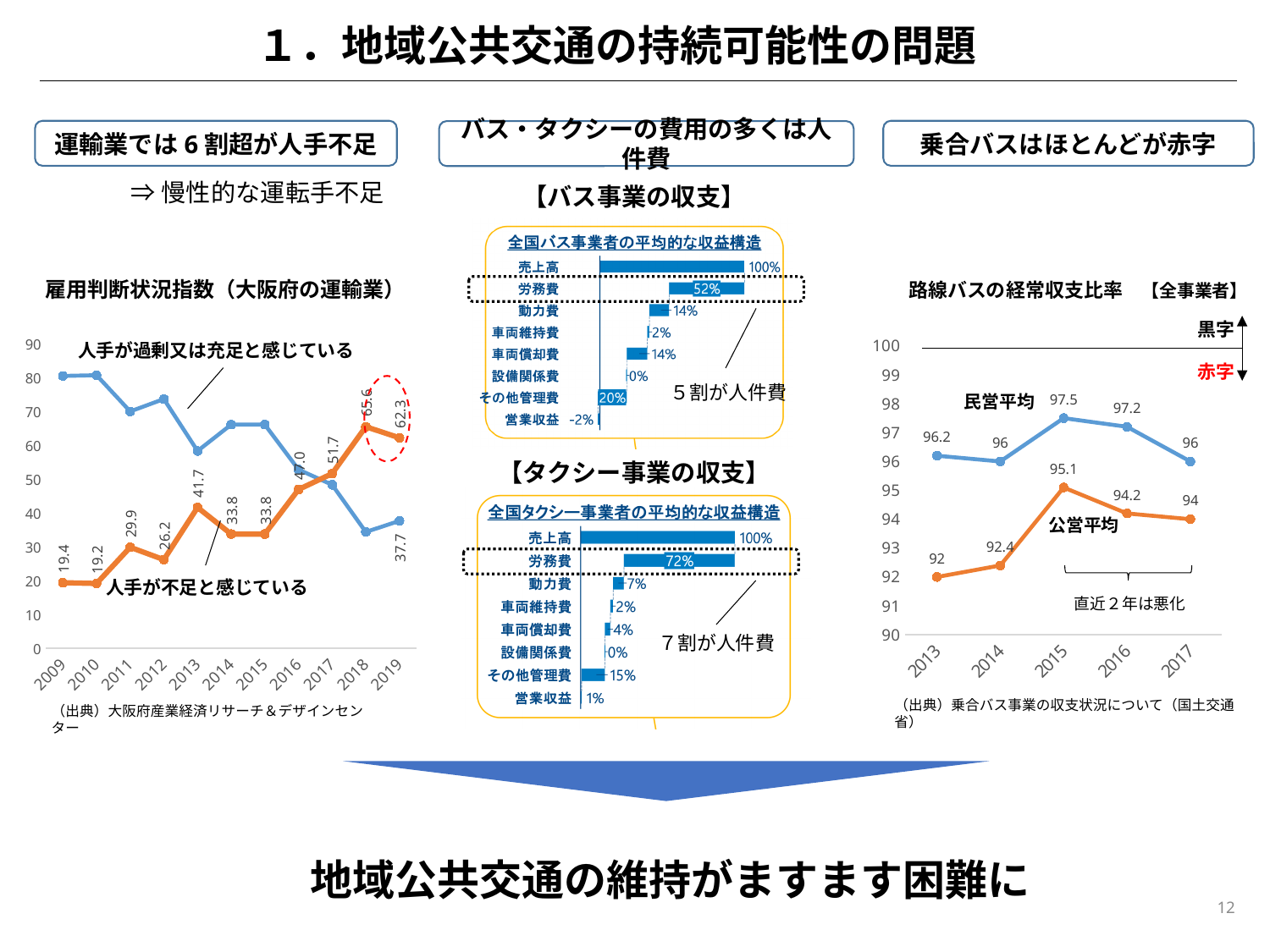
In the 雇用判断状況指数（大阪府の運輸業） chart, what is the value of the 人手が不足と感じている line in 2018? 65.6 In the 路線バスの経常収支比率 chart, what is the 公営平均 value in 2015? 95.1 In the 全国タクシー事業者の平均的な収益構造 chart, what percentage is 労務費? 72% In the 路線バスの経常収支比率 chart, what is the difference between 民営平均 and 公営平均 in 2013? 4.2 In the 雇用判断状況指数（大阪府の運輸業） chart, how many years are shown on the x axis? 11 What kind of chart is the 全国バス事業者の平均的な収益構造 chart? bar chart In the 路線バスの経常収支比率 chart, which is larger in 2017, 民営平均 or 公営平均? 民営平均 In the 雇用判断状況指数（大阪府の運輸業） chart, what is the difference between the 人手が不足と感じている values in 2017 and 2016? 4.7 In the 雇用判断状況指数（大阪府の運輸業） chart, what is the value of the 人手が過剰又は充足と感じている line in 2019? 37.7 In the 全国タクシー事業者の平均的な収益構造 chart, what percentage is その他管理費? 15% In the 雇用判断状況指数（大阪府の運輸業） chart, in which year does the 人手が不足と感じている line reach its highest value? 2018 In the 全国バス事業者の平均的な収益構造 chart, what percentage is 労務費? 52%